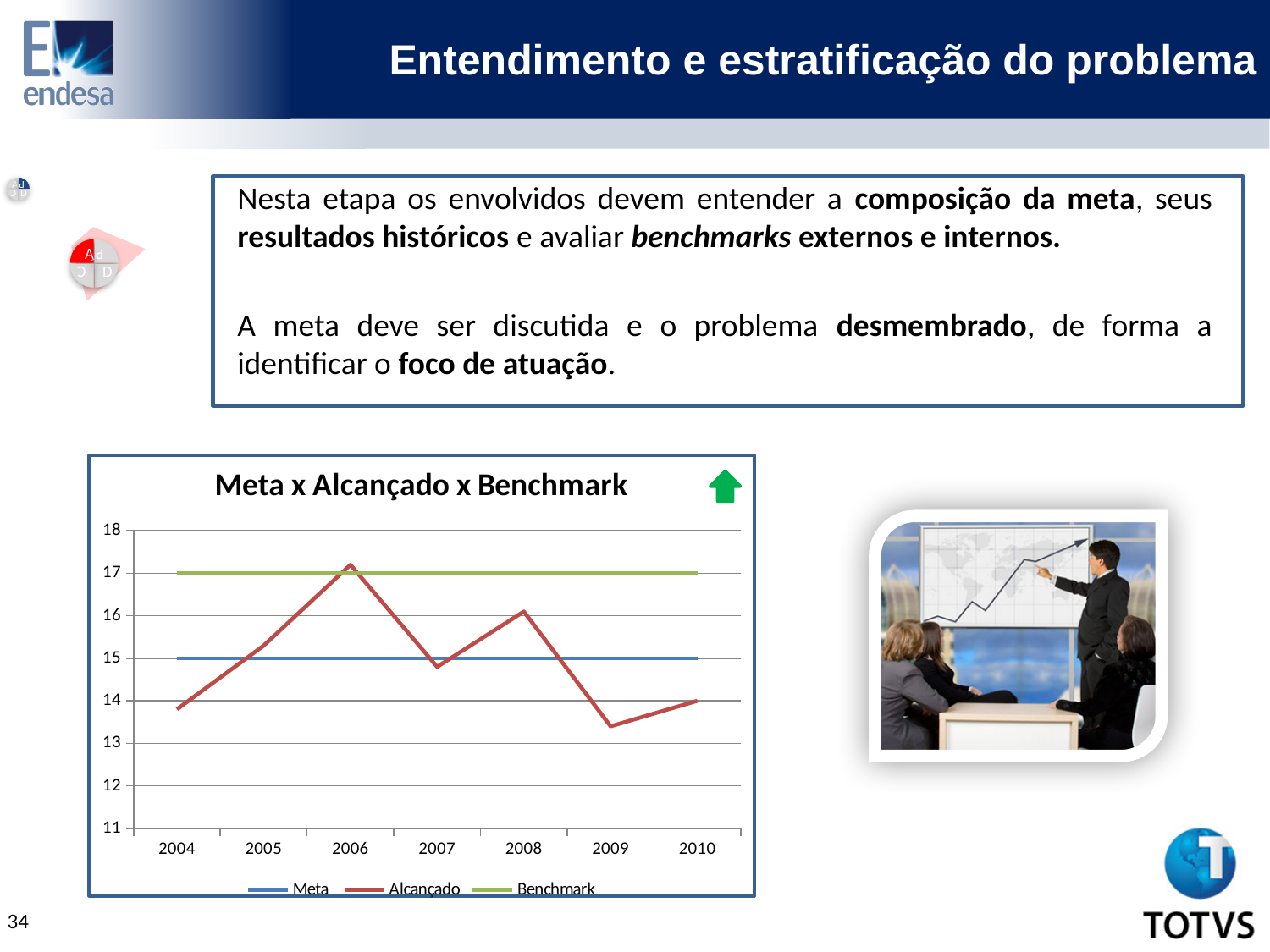
In which year is the Alcançado series lowest? 2009 Does the Alcançado series rise or fall from 2004 to 2006? rise What type of chart is shown on the slide? line chart What is the title of the chart? Meta x Alcançado x Benchmark How many years are shown on the x axis of the chart? 7 What is the value of the Meta series across the years? 15 Is the Alcançado value for 2009 greater or less than 14? less What is the value of the Benchmark series across the years? 17 What is the difference between the Benchmark value and the Meta value? 2 Is the Alcançado value for 2008 greater or less than 15? greater In which year is the Alcançado series highest? 2006 How many series does the chart legend list? 3